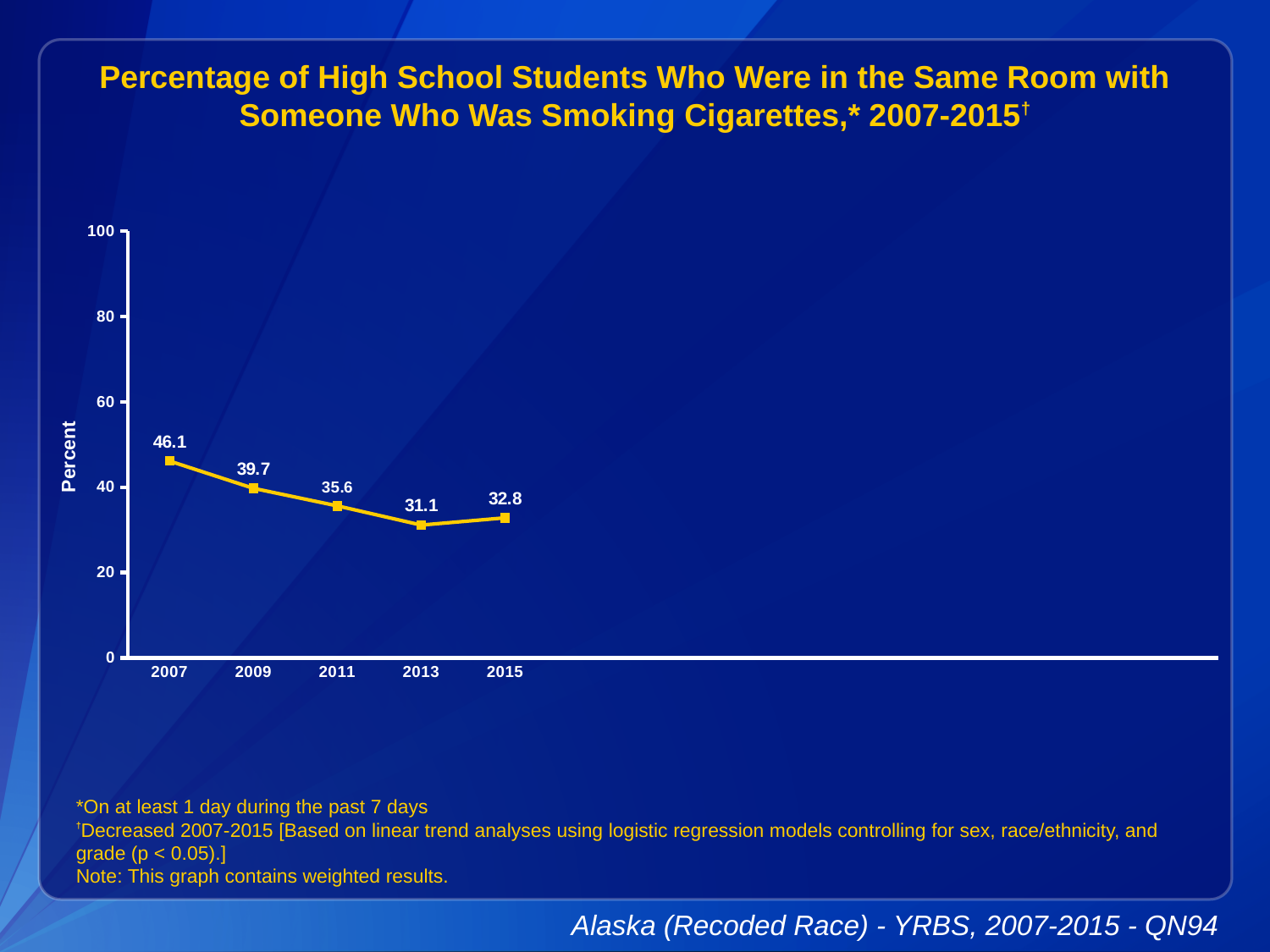
How many years are plotted on the chart? 5 What kind of chart is shown on the slide? Line chart What value is shown for 2013? 31.1 What value is shown for 2015? 32.8 What is the difference between the 2009 value and the 2011 value? 4.1 Which year has the highest value on the chart? 2007 What is the label of the y axis? Percent What is the difference between the 2007 value and the 2015 value? 13.3 What was the percentage of high school students who were in the same room with someone smoking cigarettes in 2007? 46.1 Is the value for 2009 greater or less than 40? less Which year has the lowest value on the chart? 2013 Which year has a larger value, 2011 or 2015? 2011